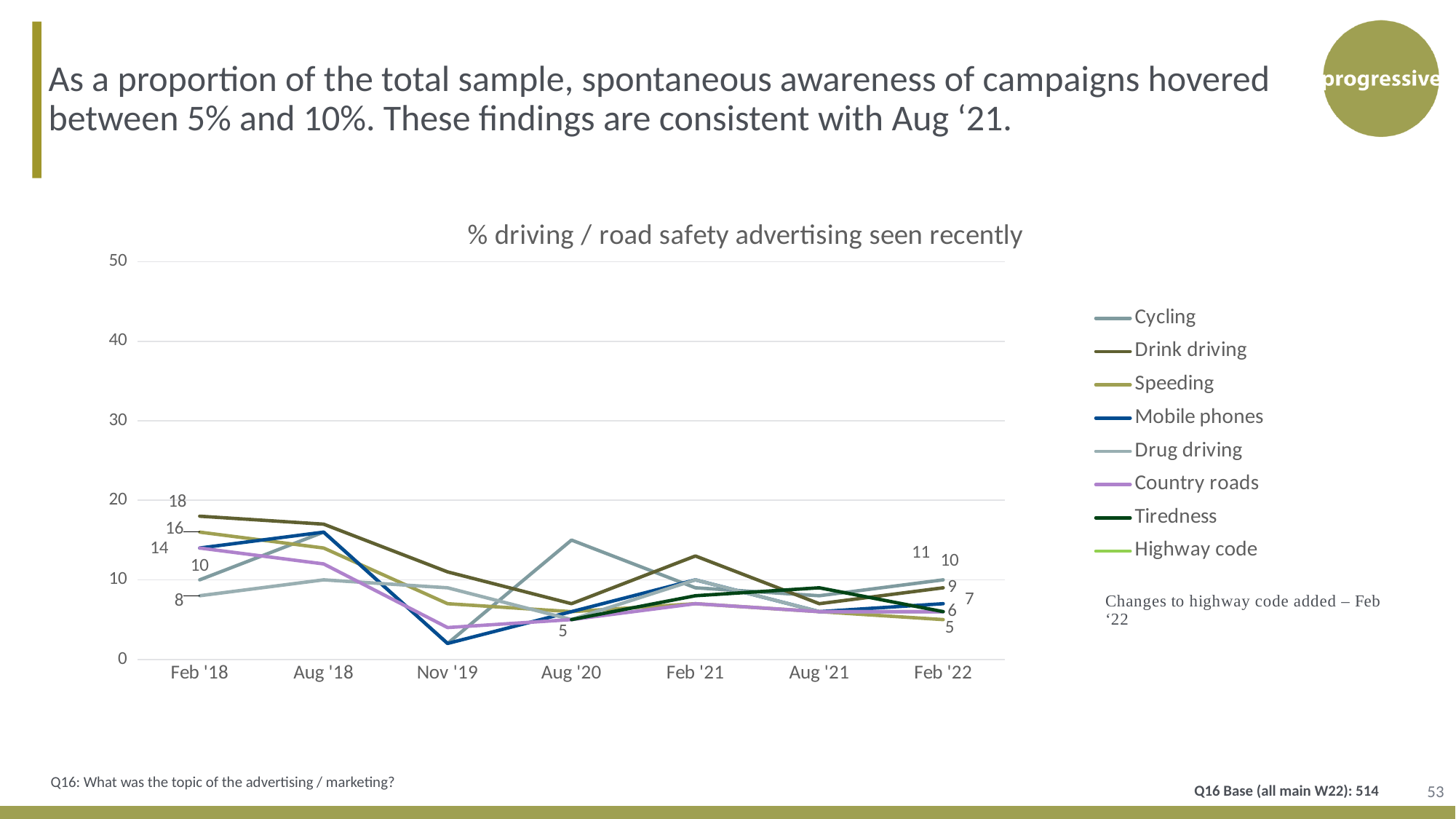
Is the value for Cycling at Aug '20 greater or less than 10? greater Which series has the highest value at Feb '18? Drink driving What is the value for Drug driving at Feb '18? 8 Is the value for Mobile phones at Nov '19 greater or less than 10? less What is the title of the chart? % driving / road safety advertising seen recently What is the value for Drink driving at Feb '18? 18 How many series does the legend list? 8 How many time points are shown on the x axis? 7 What is the difference between Drink driving and Drug driving at Feb '18? 10 What kind of chart is shown on the slide? line chart Does the Drink driving line rise or fall from Feb '18 to Nov '19? fall